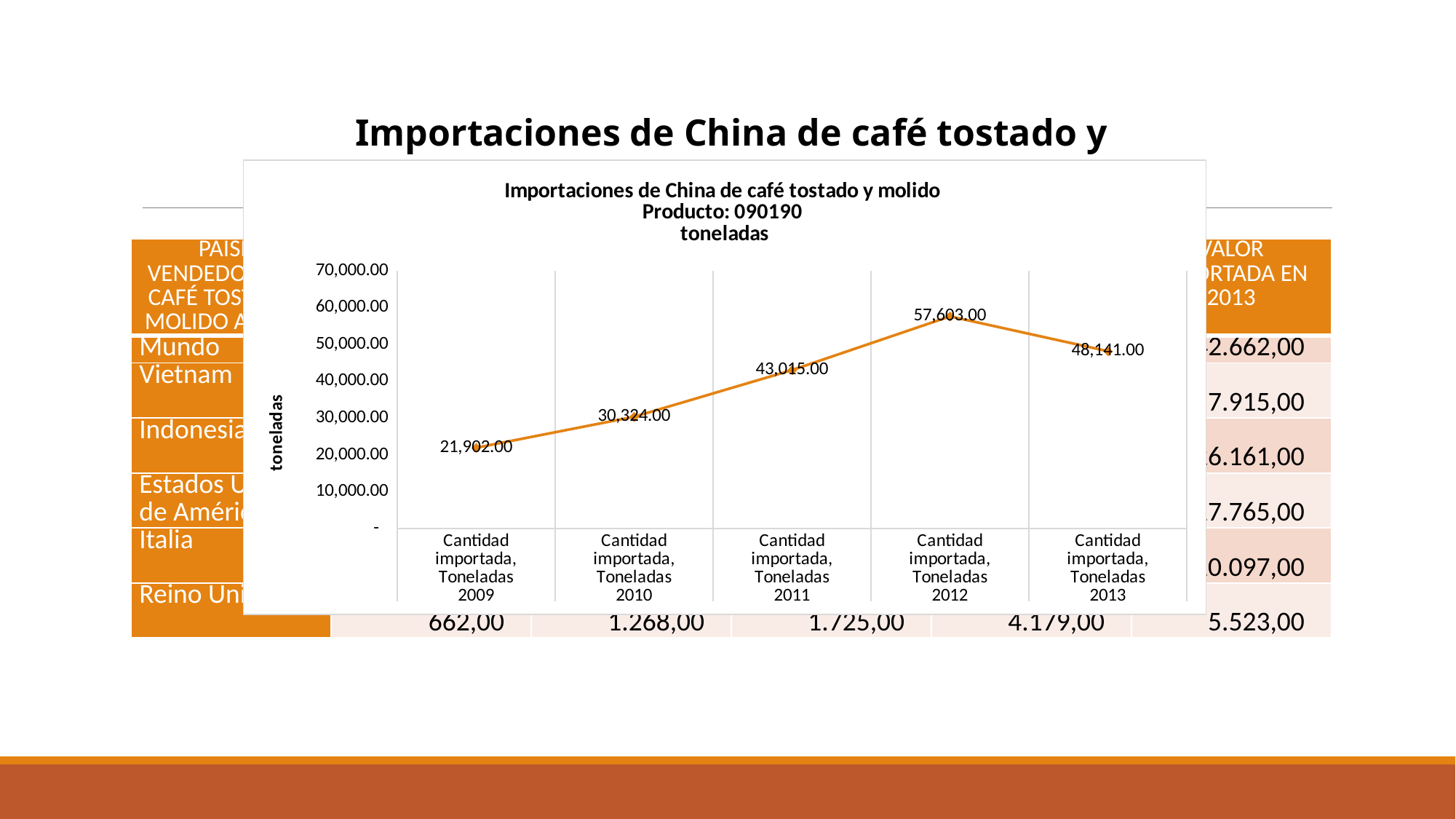
Which is larger, the quantity imported in 2011 or in 2013? 2013 What is the difference between the quantity imported in 2011 and in 2010? 12,691.00 What product code is given in the chart title? 090190 What was the quantity imported in 2013? 48,141.00 How many data points are plotted on the chart? 5 What was the quantity imported in 2012? 57,603.00 What is the difference between the quantity imported in 2012 and in 2013? 9,462.00 Which year has the lowest quantity imported? 2009 Which year has the highest quantity imported? 2012 What kind of chart is shown on the slide? line chart Do the values rise or fall from 2009 to 2012? rise What was the quantity imported in 2009? 21,902.00